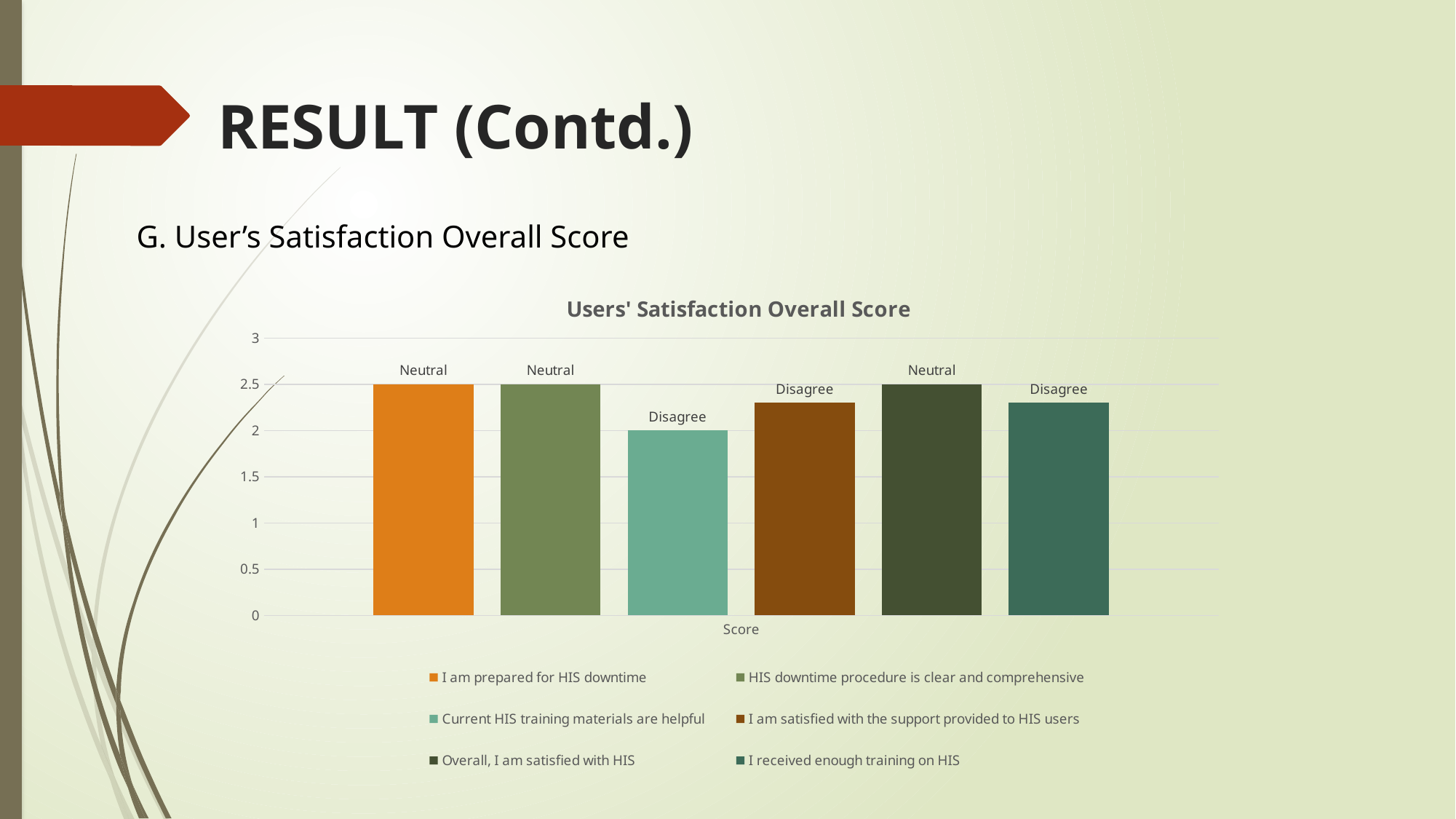
How many bars are plotted in the Users' Satisfaction Overall Score chart? 6 What score does the bar for "Current HIS training materials are helpful" reach on the axis? 2 What data label is shown above the bar for "Current HIS training materials are helpful"? Disagree Is the value for "I received enough training on HIS" greater or less than 2.5? less How many series does the legend of the Users' Satisfaction Overall Score chart list? 6 What kind of chart is shown on the slide? bar chart What data label is shown above the bar for "Overall, I am satisfied with HIS"? Neutral Which is larger: the bar for "HIS downtime procedure is clear and comprehensive" or the bar for "Current HIS training materials are helpful"? HIS downtime procedure is clear and comprehensive Is the value for "I am satisfied with the support provided to HIS users" greater or less than 2? greater What data label is shown above the bar for "I am prepared for HIS downtime"? Neutral What score does the bar for "I am prepared for HIS downtime" reach on the axis? 2.5 Which series has the lowest bar in the Users' Satisfaction Overall Score chart? Current HIS training materials are helpful